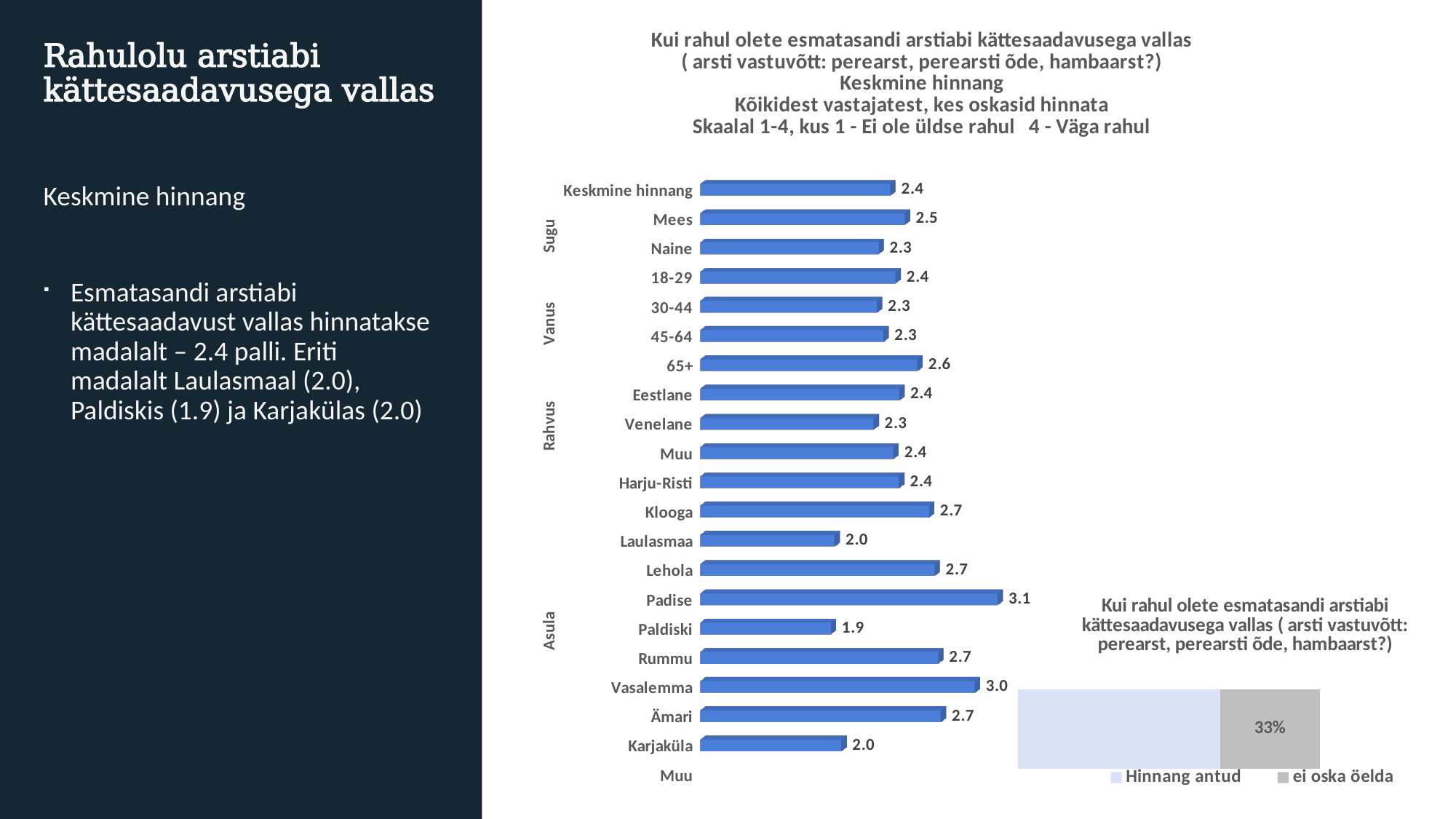
What kind of chart is the main chart on the slide? bar chart In the main bar chart, what is the value for Padise? 3.1 In the main bar chart, what is the value for 65+? 2.6 In the small chart at the bottom right, what share is labelled for 'ei oska öelda'? 33% In the main bar chart, which category has the lowest value? Paldiski How many series does the legend of the small chart at the bottom right list? 2 In the main bar chart, which has a higher value, Vasalemma or Laulasmaa? Vasalemma In the main bar chart, what is the difference between the values for Eestlane and Venelane? 0.1 In the main bar chart, what is the difference between the values for Padise and Paldiski? 1.2 In the main bar chart, what is the value for Keskmine hinnang? 2.4 In the main bar chart, which has a higher value, Mees or Naine? Mees In the main bar chart, which category has the highest value? Padise